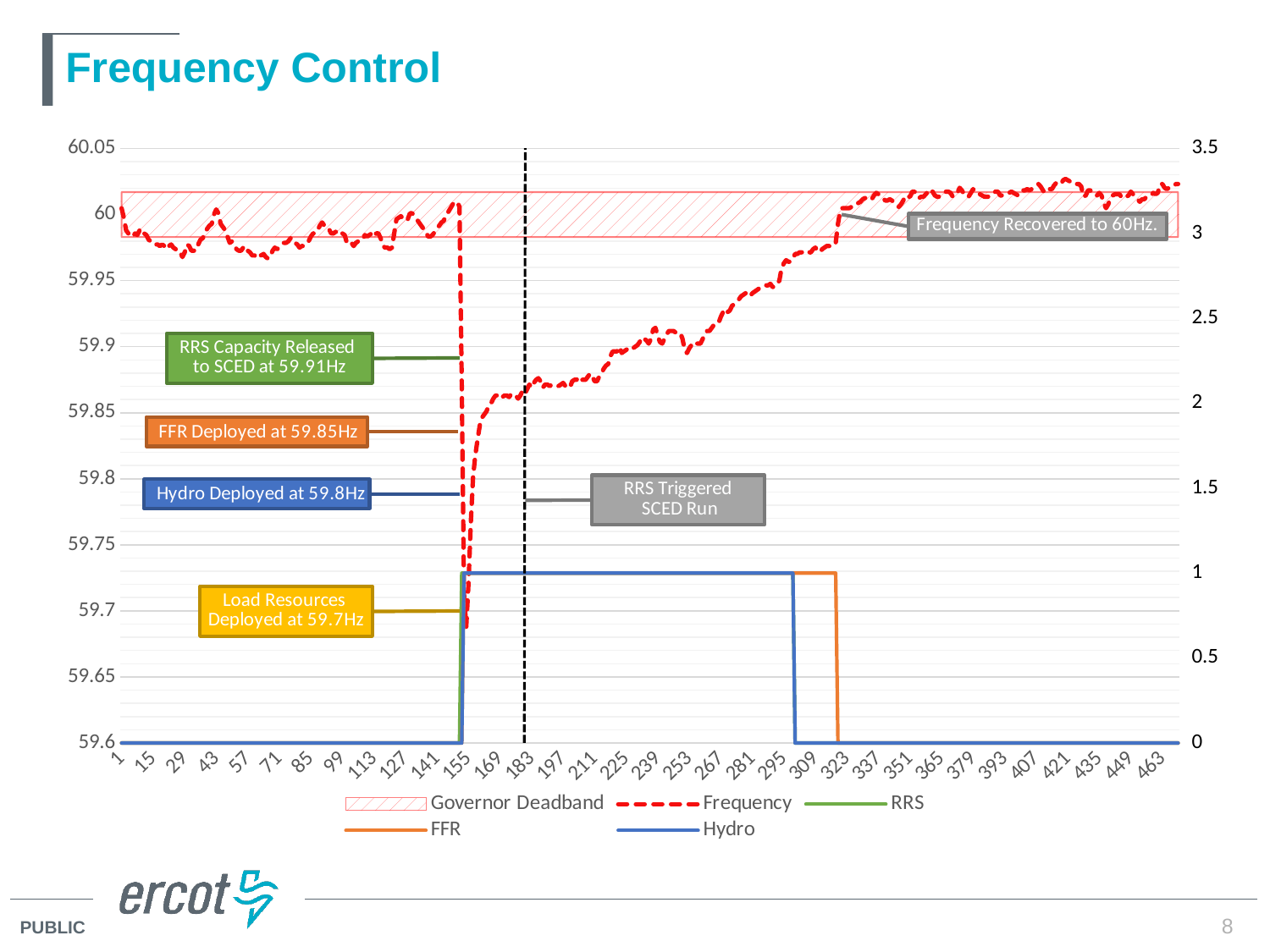
Which series returns to 0 first, Hydro or FFR? Hydro At what frequency was Hydro deployed, according to the annotation? 59.8Hz At what frequency was RRS capacity released to SCED, according to the annotation? 59.91Hz Is the Frequency value at x=463 greater or less than 60? greater What kind of chart is shown on the slide? line chart Which series are listed in the legend? Governor Deadband, Frequency, RRS, FFR, Hydro At what frequency was FFR deployed, according to the annotation? 59.85Hz Does the Frequency series rise or fall between x=183 and x=337? rise Is the lowest Frequency value (near x=155) greater or less than 59.8? less At what frequency were Load Resources deployed, according to the annotation? 59.7Hz How many series does the legend list? 5 What value does the Hydro series hold on the right axis while it is deployed (between about x=155 and x=309)? 1